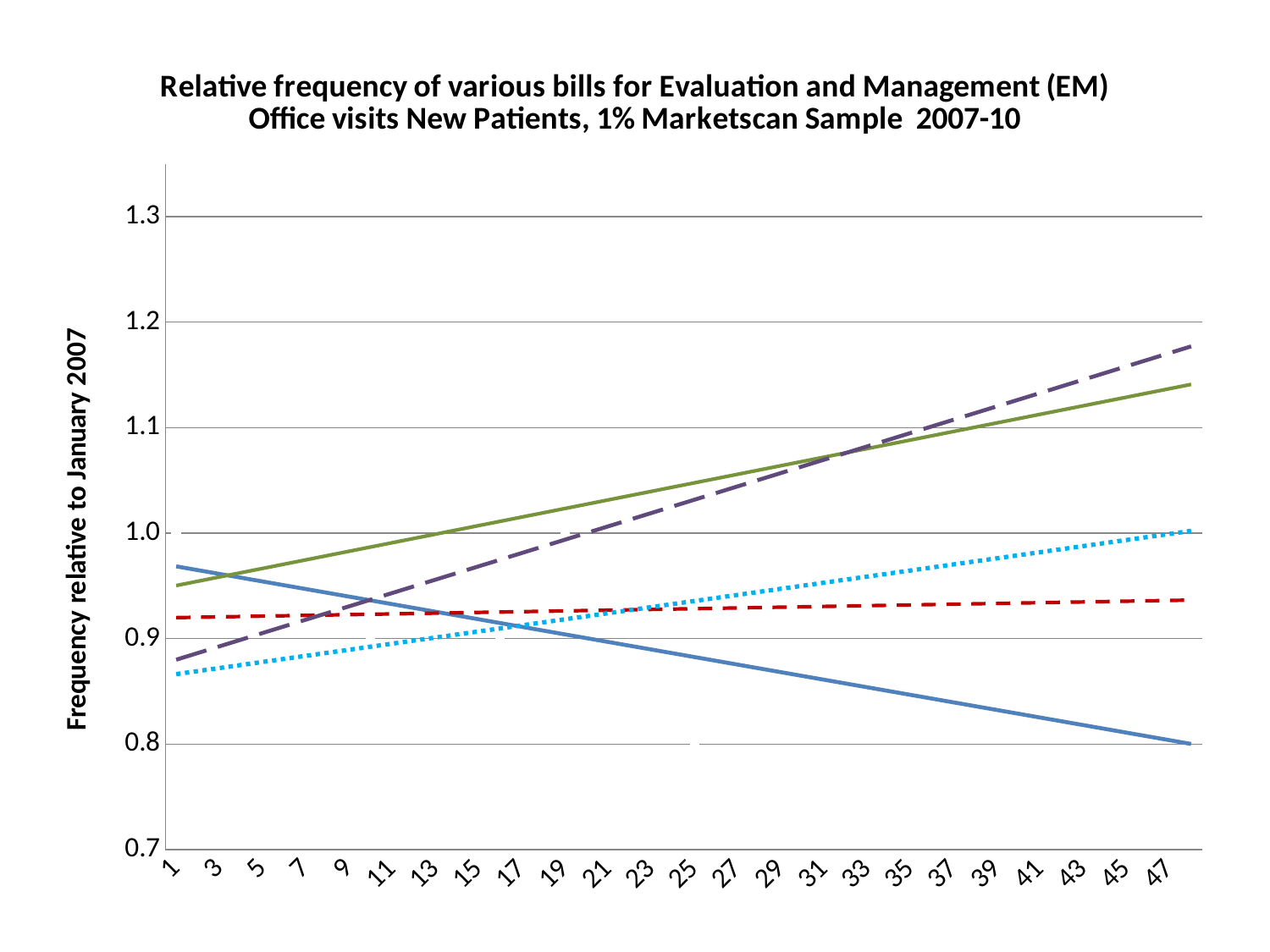
Is the value of the solid blue line at x = 47 greater or less than 0.9? less At x = 47, which is higher: the solid green line or the solid blue line? solid green line Is the value of the dashed purple line at x = 47 greater or less than 1.1? greater What kind of chart is shown on the slide? line chart Does the solid green line rise or fall from left to right along the x axis? rise Does the solid blue line rise or fall from left to right along the x axis? fall How many lines are plotted on the chart? 5 Which line has the lowest value at the right end of the chart? solid blue line What is the label on the y axis of the chart? Frequency relative to January 2007 Which line has the highest value at the right end of the chart? dashed purple line Is the value of the dotted light blue line at x = 1 greater or less than 0.9? less Does the dashed purple line rise or fall from left to right along the x axis? rise